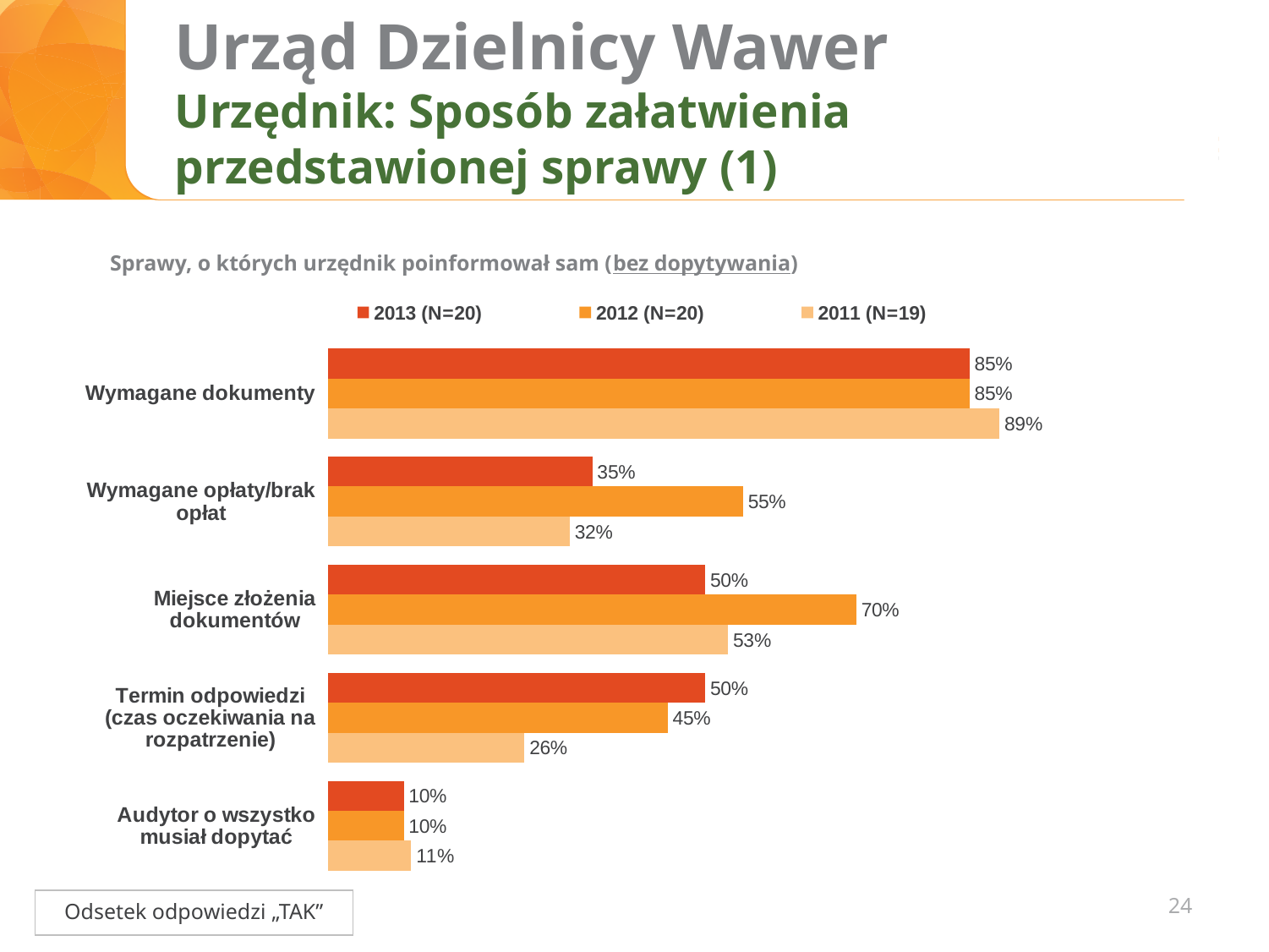
Which category has the lowest value in the 2012 (N=20) series? Audytor o wszystko musiał dopytać What is the value for "Wymagane dokumenty" in the 2013 (N=20) series? 85% What is the difference between the 2011 (N=19) and 2013 (N=20) values for "Wymagane dokumenty"? 4% What is the value for "Termin odpowiedzi (czas oczekiwania na rozpatrzenie)" in the 2011 (N=19) series? 26% What is the value for "Miejsce złożenia dokumentów" in the 2012 (N=20) series? 70% Which category has the highest value in the 2011 (N=19) series? Wymagane dokumenty For "Termin odpowiedzi (czas oczekiwania na rozpatrzenie)", which series has the larger value: 2013 (N=20) or 2012 (N=20)? 2013 (N=20) How many series does the legend list? 3 How many categories are shown on the chart? 5 What is the subtitle text shown above the chart? Sprawy, o których urzędnik poinformował sam (bez dopytywania) What is the difference between the 2012 (N=20) and 2013 (N=20) values for "Wymagane opłaty/brak opłat"? 20% What kind of chart is shown on the slide? Bar chart